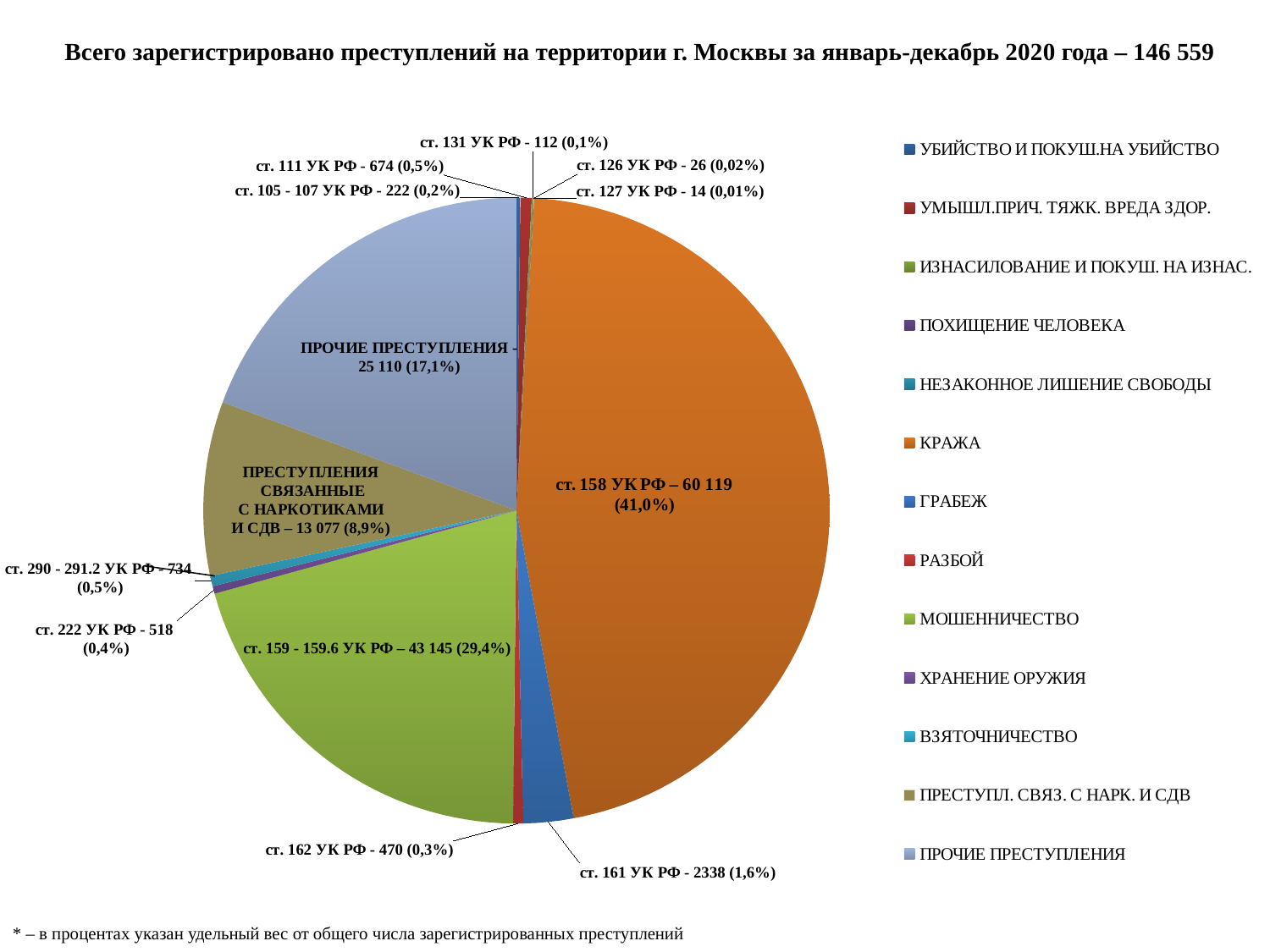
What total number of registered crimes is stated in the slide title? 146 559 What share of the pie does the slice for ПРЕСТУПЛЕНИЯ СВЯЗАННЫЕ С НАРКОТИКАМИ И СДВ represent? 8,9% Which category has the smallest value on the pie chart? ст. 127 УК РФ - 14 (0,01%) What is the value shown for ст. 158 УК РФ (КРАЖА) on the pie chart? 60 119 (41,0%) Which is larger, the value for ст. 111 УК РФ or the value for ст. 222 УК РФ? ст. 111 УК РФ What is the value shown for ПРОЧИЕ ПРЕСТУПЛЕНИЯ on the pie chart? 25 110 (17,1%) What is the value shown for ст. 159 - 159.6 УК РФ on the pie chart? 43 145 (29,4%) What is the difference between the values for ст. 158 УК РФ and ст. 159 - 159.6 УК РФ? 16 974 What kind of chart is shown on the slide? pie chart What is the value shown for ст. 161 УК РФ on the pie chart? 2338 (1,6%) How many entries does the legend of the pie chart list? 13 Which category has the largest slice of the pie chart? ст. 158 УК РФ (КРАЖА)